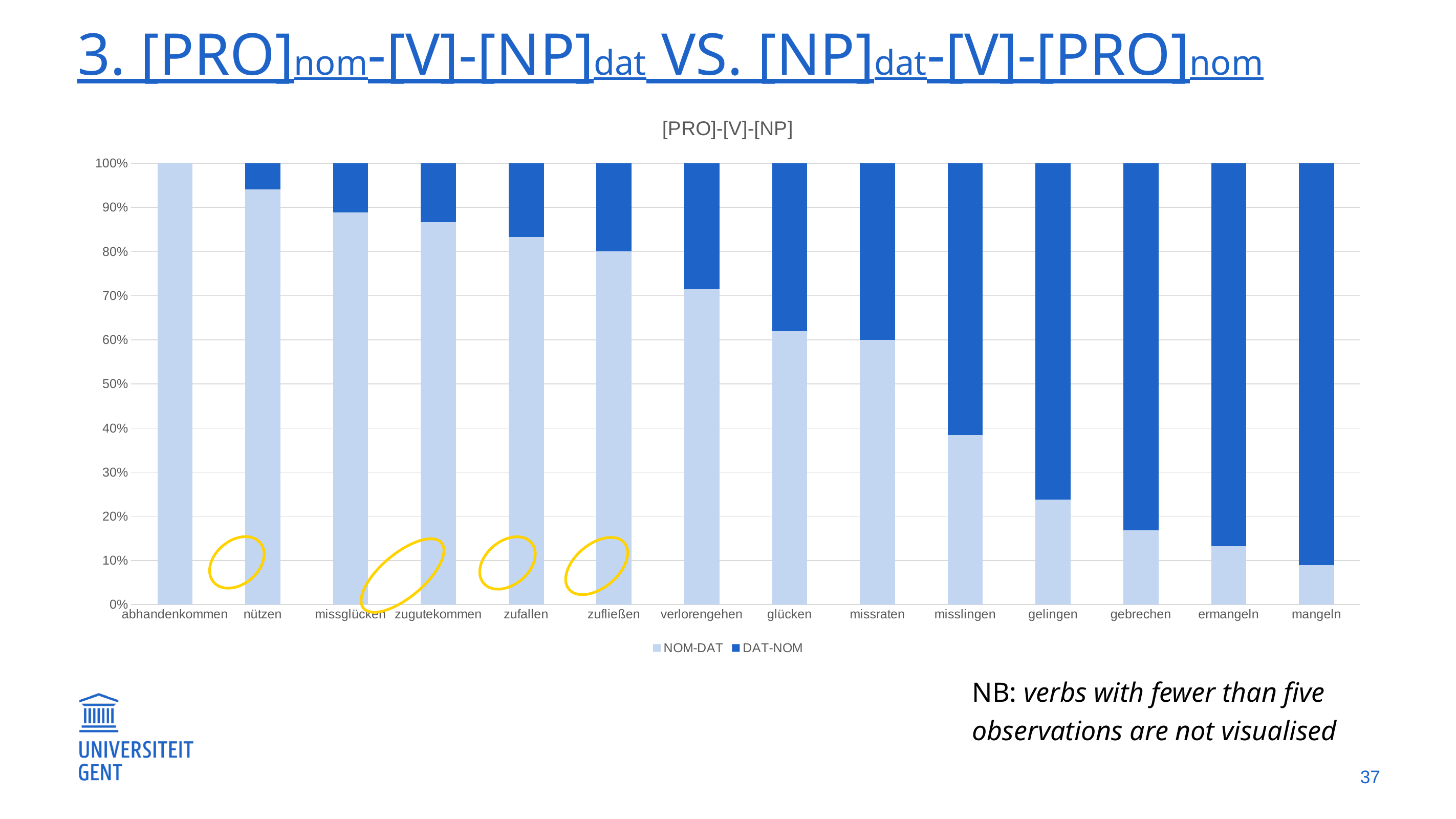
What is the NOM-DAT share for abhandenkommen? 100% What is the title of the chart? [PRO]-[V]-[NP] Is the NOM-DAT share for glücken greater or less than 50%? greater Is the NOM-DAT share for gelingen greater or less than 30%? less Is the NOM-DAT share for verlorengehen greater or less than 80%? less Which verb has the highest NOM-DAT share? abhandenkommen How many series does the chart's legend list? 2 How many verbs (categories) are shown on the x axis of the chart? 14 What kind of chart is shown on the slide? stacked bar chart Which verb has a larger NOM-DAT share, zufallen or gelingen? zufallen Which verb has the lowest NOM-DAT share? mangeln Which verb has the largest DAT-NOM share? mangeln